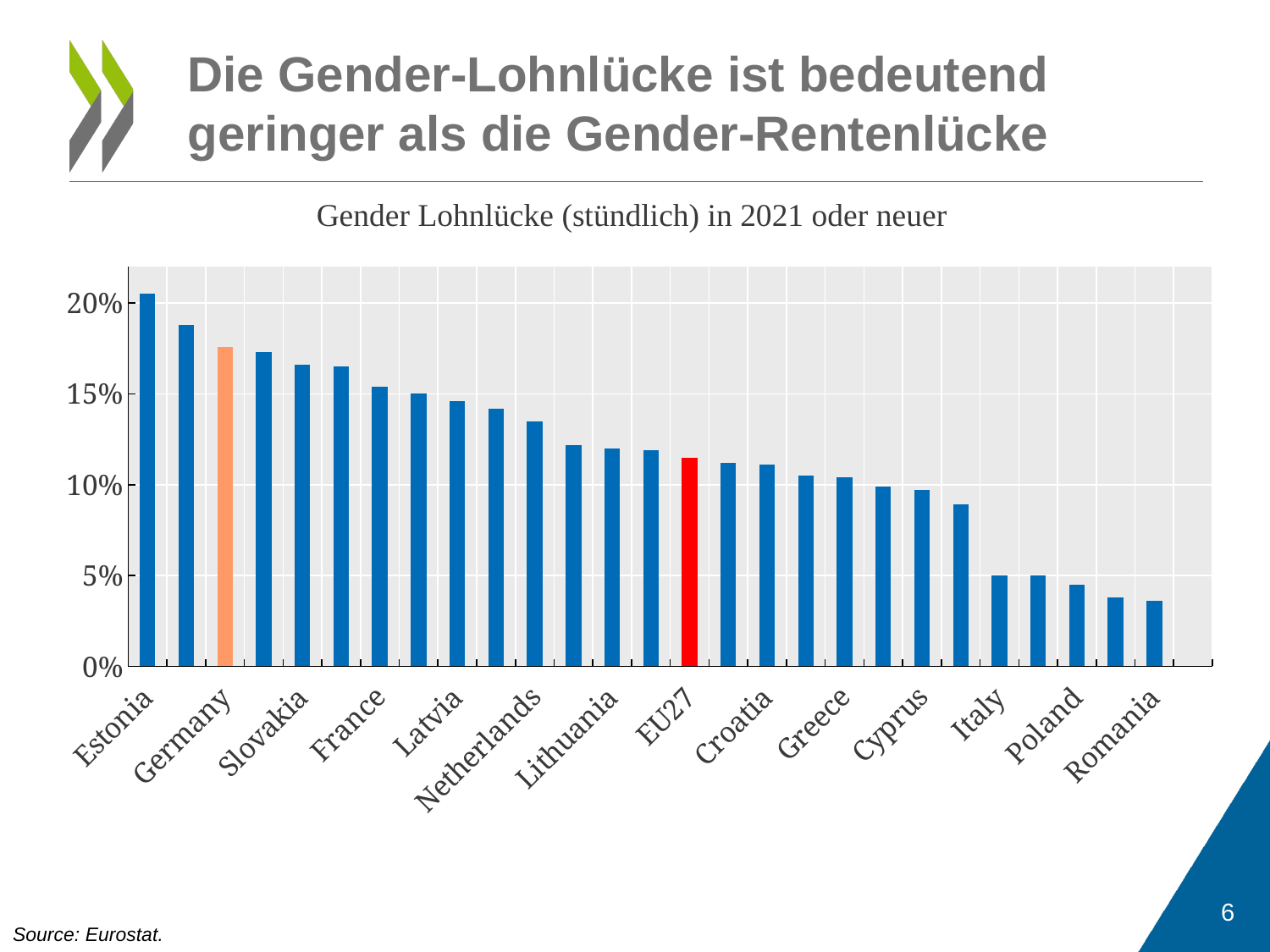
Which country has the highest gender pay gap in the chart? Estonia Do the values rise or fall from left to right along the x axis? fall Is the value for Italy greater or less than 10%? less Is the value for EU27 greater or less than 10%? greater Is the value for Germany greater or less than 15%? greater What colour is the bar for EU27? red Which country has the lowest gender pay gap in the chart? Romania Which has a larger gender pay gap, Germany or France? Germany Which has a larger gender pay gap, Latvia or Croatia? Latvia What kind of chart is shown on the slide? bar chart